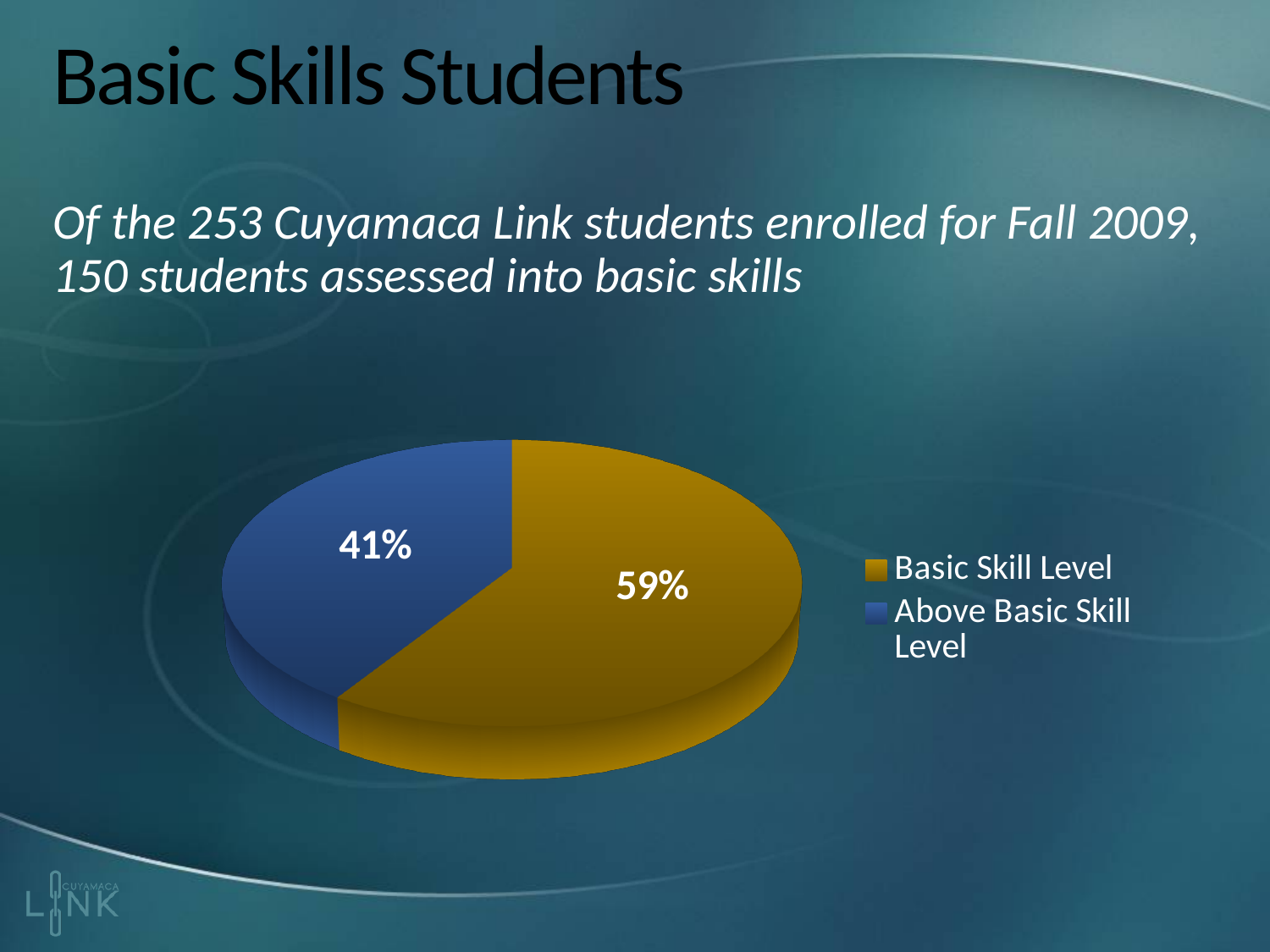
How many entries does the legend list? 2 What percentage of the pie is labelled Basic Skill Level? 59% How many slices does the pie chart have? 2 What colour is the Above Basic Skill Level slice? blue What kind of chart is shown on the slide? pie chart Is the share for Basic Skill Level greater or less than 50%? greater What percentage of the pie is labelled Above Basic Skill Level? 41% What colour is the Basic Skill Level slice? gold Which slice of the pie is the smallest? Above Basic Skill Level Which slice of the pie is the largest? Basic Skill Level Which is larger, the Basic Skill Level slice or the Above Basic Skill Level slice? Basic Skill Level What is the difference in percentage points between the Basic Skill Level slice and the Above Basic Skill Level slice? 18